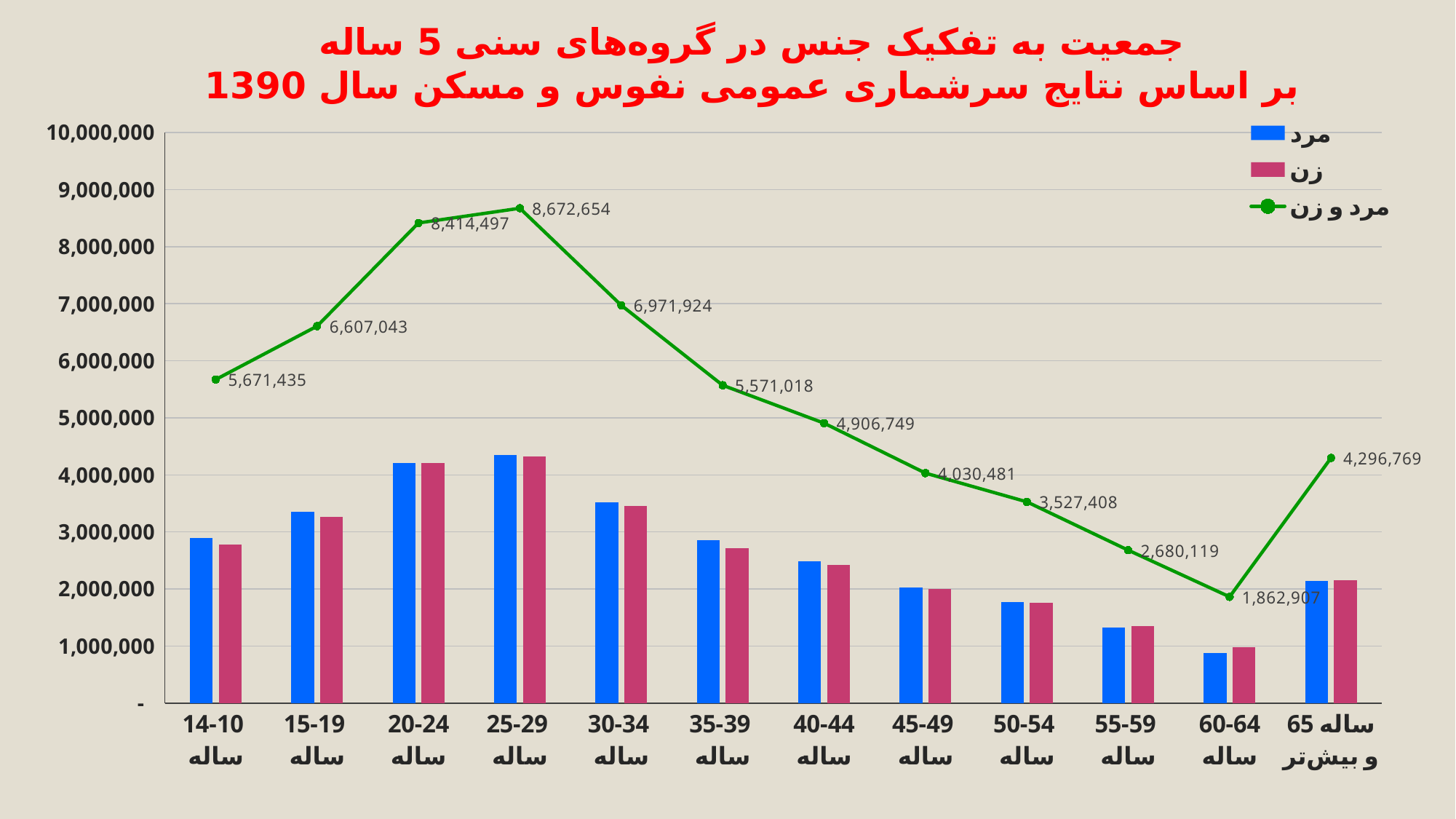
Is the مرد bar for the 60-64 ساله age group greater or less than 1,000,000? less What is the value of the مرد و زن line for the 14-10 ساله age group? 5,671,435 Is the مرد bar for the 20-24 ساله age group greater or less than 4,000,000? greater How many age groups are shown on the x axis? 12 Which age group has the highest value on the مرد و زن line? 25-29 ساله What is the value of the مرد و زن line for the 25-29 ساله age group? 8,672,654 Which age group has the lowest value on the مرد و زن line? 60-64 ساله Does the مرد و زن line rise or fall from the 25-29 ساله group to the 60-64 ساله group? fall Which is larger on the مرد و زن line: the 30-34 ساله value or the 35-39 ساله value? 30-34 ساله How many series does the legend list? 3 What is the difference between the مرد و زن values for the 25-29 ساله and 20-24 ساله age groups? 258,157 What is the value of the مرد و زن line for the 65 ساله و بیش‌تر age group? 4,296,769